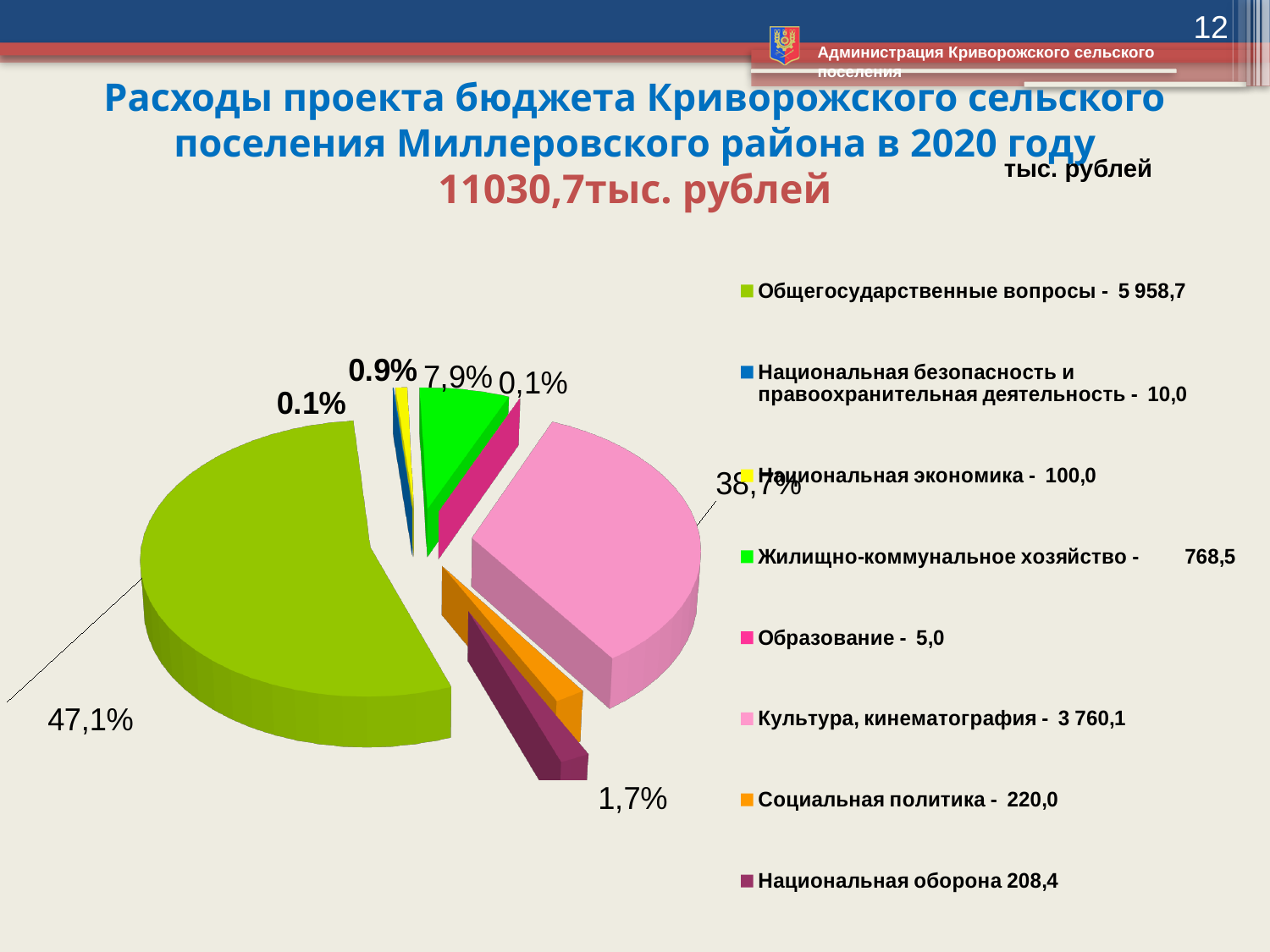
Which category has the smallest value in the pie chart? Образование What value is shown in the legend for Национальная экономика? 100,0 What is the difference between the values for Общегосударственные вопросы and Культура, кинематография? 2 198,6 What total amount of expenditures is stated in the slide title? 11030,7 тыс. рублей How many categories does the legend of the pie chart list? 8 What value is shown in the legend for Культура, кинематография? 3 760,1 Which category has the largest value in the pie chart? Общегосударственные вопросы Which is larger: the value for Жилищно-коммунальное хозяйство or for Социальная политика? Жилищно-коммунальное хозяйство What is the difference between the values for Социальная политика and Национальная оборона? 11,6 What value is shown in the legend for Общегосударственные вопросы? 5 958,7 What kind of chart is shown on the slide? pie chart What share of the pie does Общегосударственные вопросы take, according to the data label? 47,1%